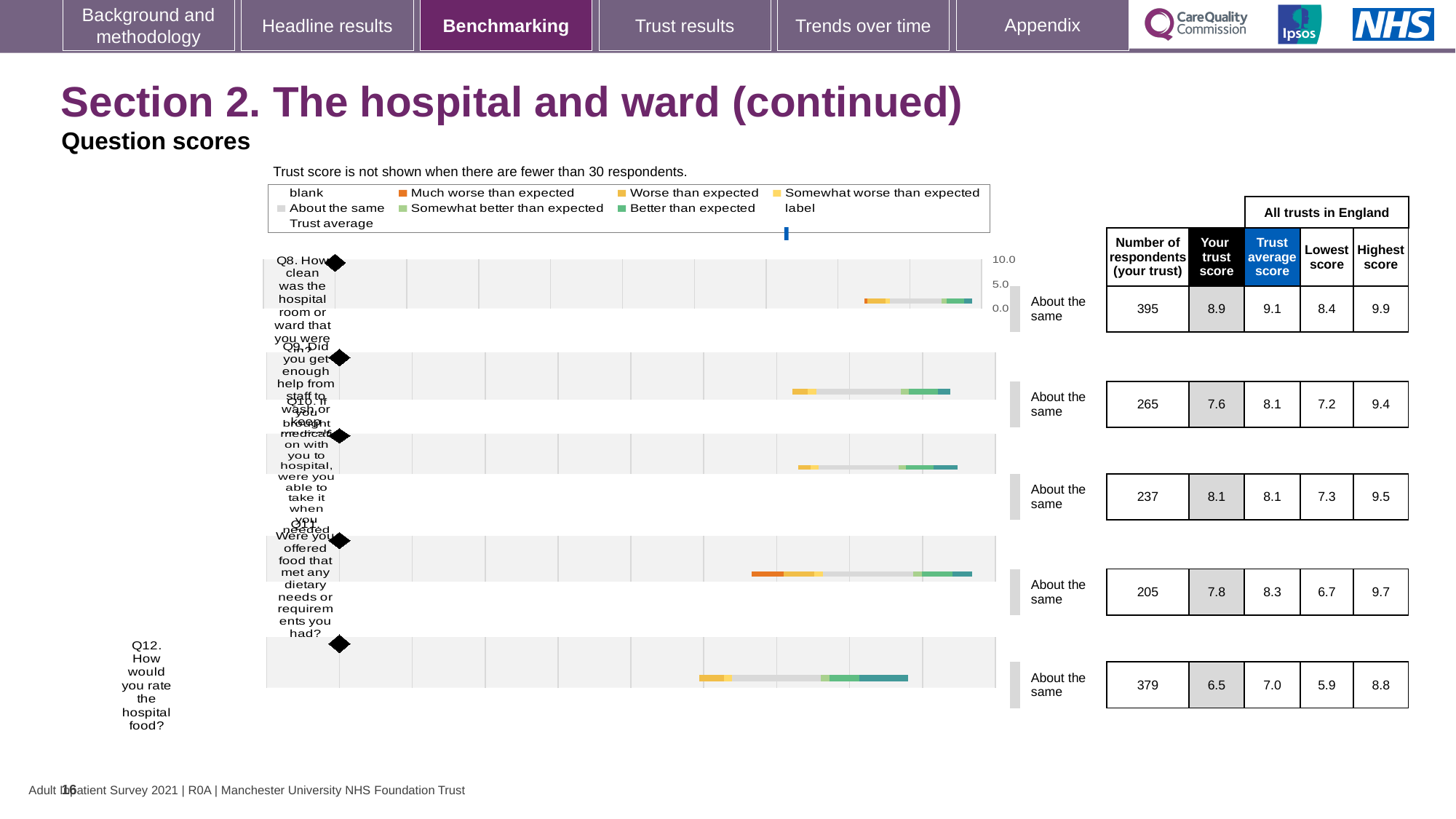
What is the lowest score across all trusts in England for Q12? 5.9 For Q8, how much higher is the trust average score than your trust score? 0.2 How many respondents from your trust answered Q12 (How would you rate the hospital food)? 379 For Q9, which is larger: your trust score or the trust average score? Trust average score Which question has the highest 'Your trust score' on this slide? Q8 What benchmark category is shown next to the bar for Q10? About the same What is the trust average score for Q11 (Were you offered food that met any dietary needs or requirements you had)? 8.3 What is the highest score across all trusts in England for Q9 (Did you get enough help from staff to wash or keep yourself clean)? 9.4 Which question has the lowest 'Your trust score' on this slide? Q12 What is the 'Your trust score' for Q8 (How clean was the hospital room or ward)? 8.9 How many questions are plotted on this slide? 5 For Q12, what is the difference between the highest score and the lowest score across all trusts in England? 2.9